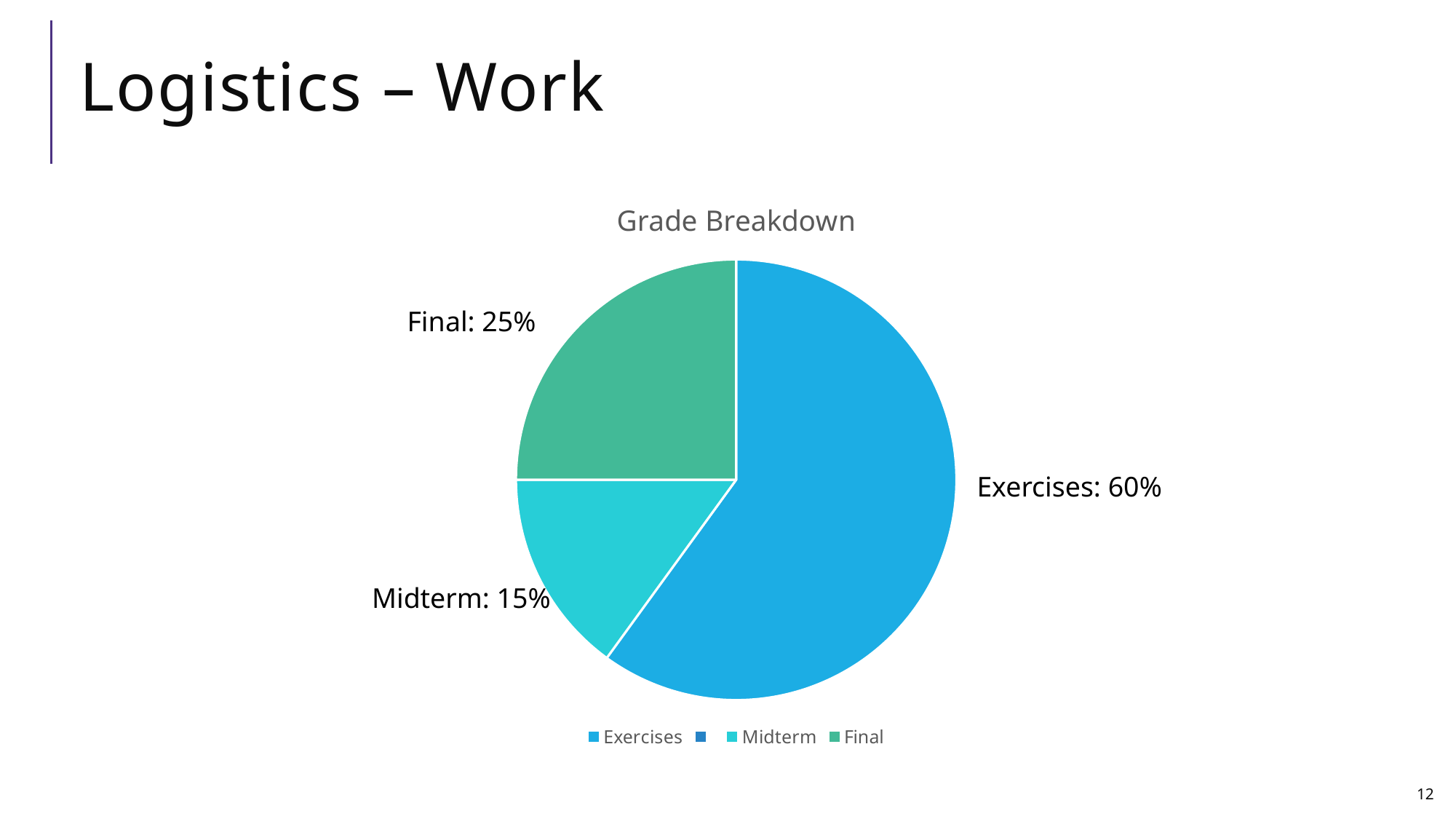
Which component makes up the smallest share of the grade? Midterm What percentage of the grade comes from the Midterm? 15% What is the combined share of the Midterm and Final? 40% What percentage of the grade comes from Exercises? 60% Which component makes up the largest share of the grade? Exercises How many slices does the pie chart have? 3 What kind of chart is shown on the slide? pie chart How many percentage points larger is the Final share than the Midterm share? 10 What percentage of the grade comes from the Final? 25% Which is larger, the Final share or the Midterm share? Final How many percentage points larger is the Exercises share than the Final share? 35 What is the title of the chart? Grade Breakdown